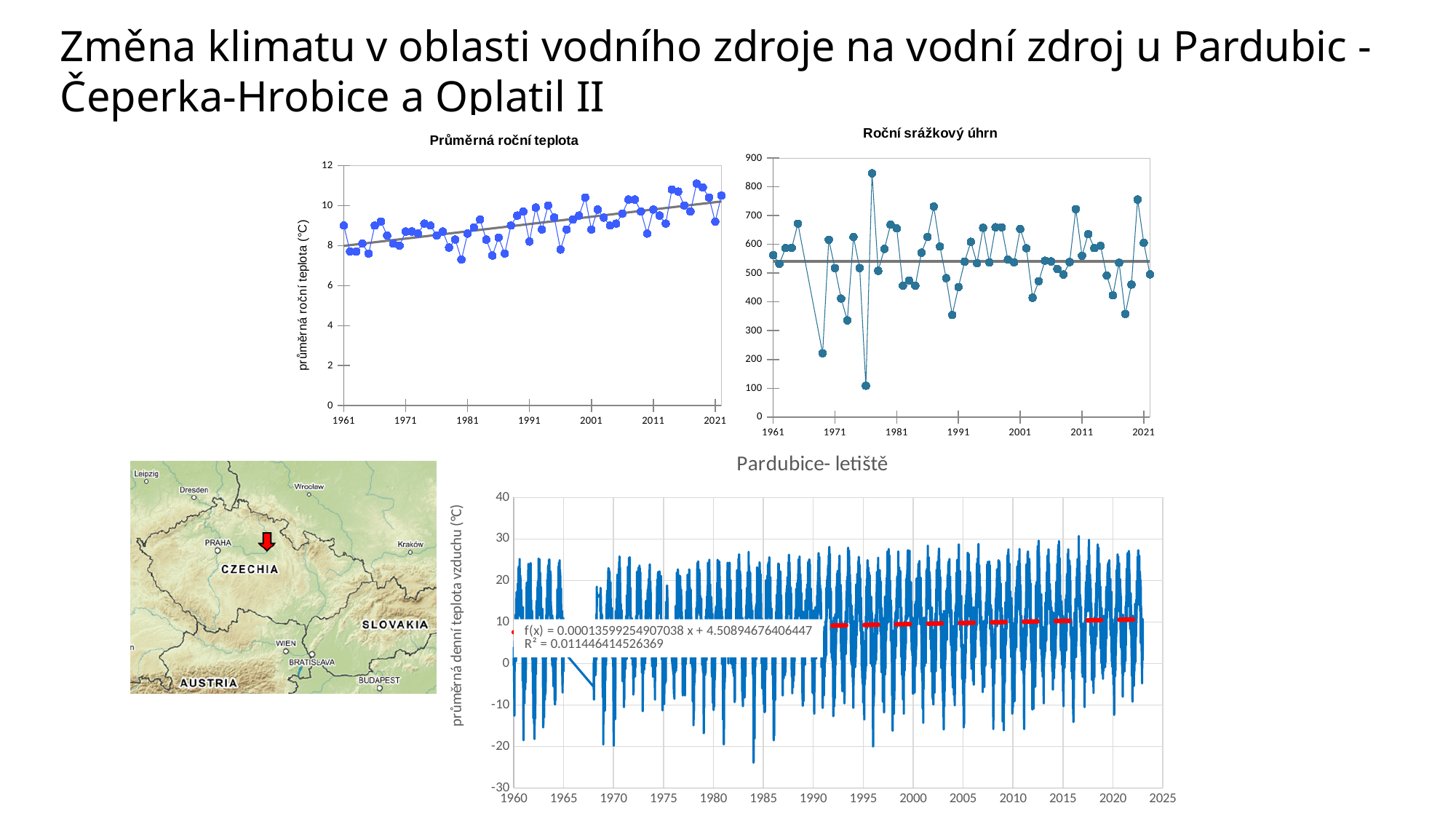
In the 'Roční srážkový úhrn' chart, is the highest plotted value greater or less than 800? greater What kind of chart is the 'Průměrná roční teplota' chart? line chart In the 'Průměrná roční teplota' chart, is the value for 1961 greater or less than 8? greater In the 'Průměrná roční teplota' chart, do the values generally rise or fall from 1961 to 2021? rise What is the title of the chart in the top right of the slide? Roční srážkový úhrn In the 'Roční srážkový úhrn' chart, is the value for 1961 greater or less than 500? greater What R² value is printed on the 'Pardubice- letiště' chart? 0.011446414526369 In the 'Roční srážkový úhrn' chart, does the grey trend line rise, fall, or stay flat across the years? flat What is the y-axis label of the 'Pardubice- letiště' chart? průměrná denní teplota vzduchu (°C) What kind of chart is the 'Pardubice- letiště' chart at the bottom of the slide? line chart